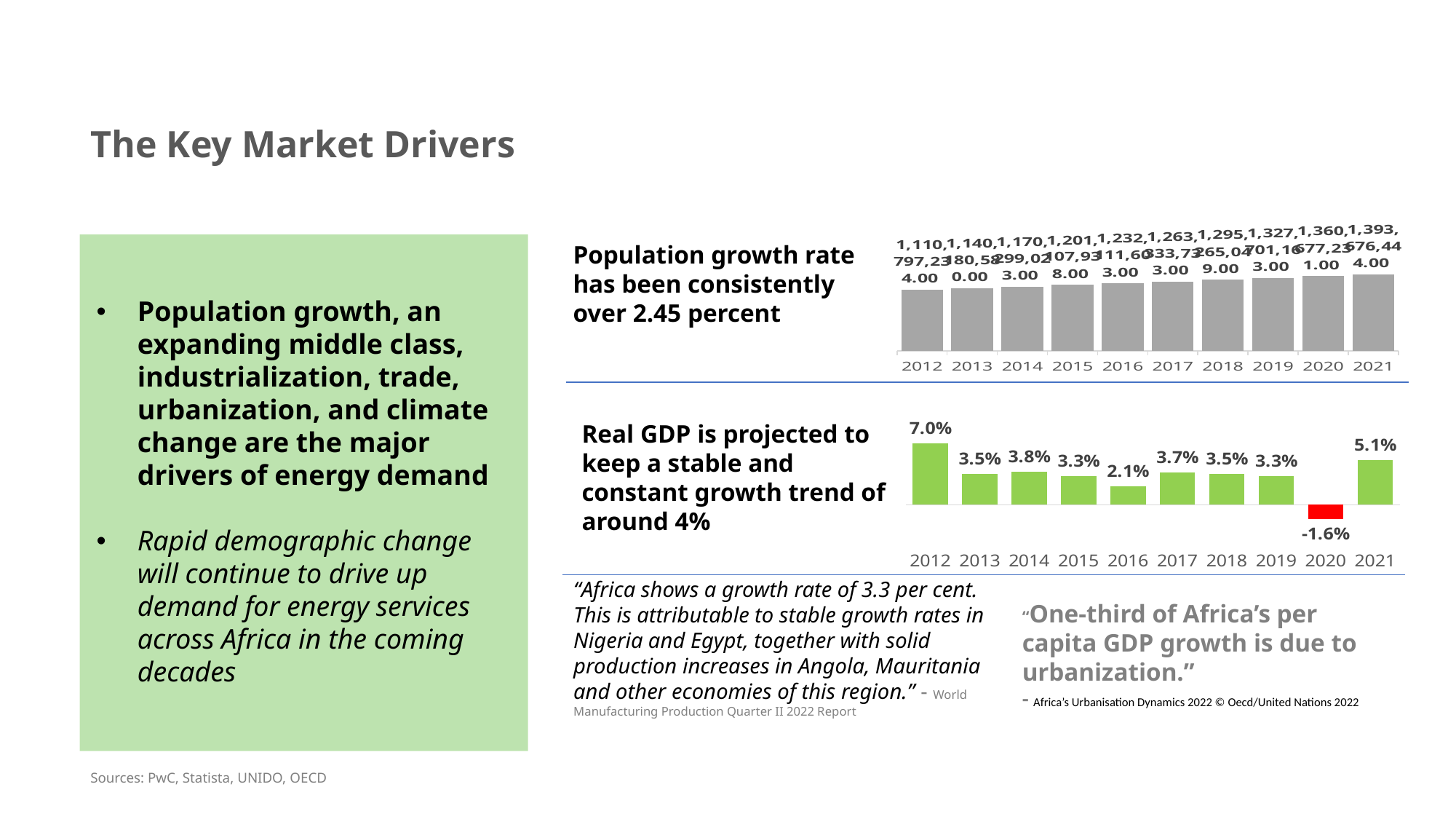
In the top chart next to the text 'Population growth rate has been consistently over 2.45 percent', how many years are shown on the x axis? 10 What kind of chart is the top chart next to the text 'Population growth rate has been consistently over 2.45 percent'? Bar chart In the bottom chart showing real GDP growth, what is the value for 2020? -1.6% In the bottom chart showing real GDP growth, what is the difference between the 2012 value and the 2021 value? 1.9% In the bottom chart showing real GDP growth, what is the value for 2016? 2.1% In the bottom chart showing real GDP growth, which year has the highest value? 2012 What kind of chart is the bottom chart showing real GDP growth? Bar chart In the bottom chart showing real GDP growth, which year has the larger value, 2014 or 2017? 2014 In the bottom chart showing real GDP growth, how many years are plotted? 10 In the bottom chart showing real GDP growth, which year has the lowest value? 2020 In the bottom chart showing real GDP growth, what is the value for 2012? 7.0% In the bottom chart showing real GDP growth, which bar is coloured red instead of green? 2020